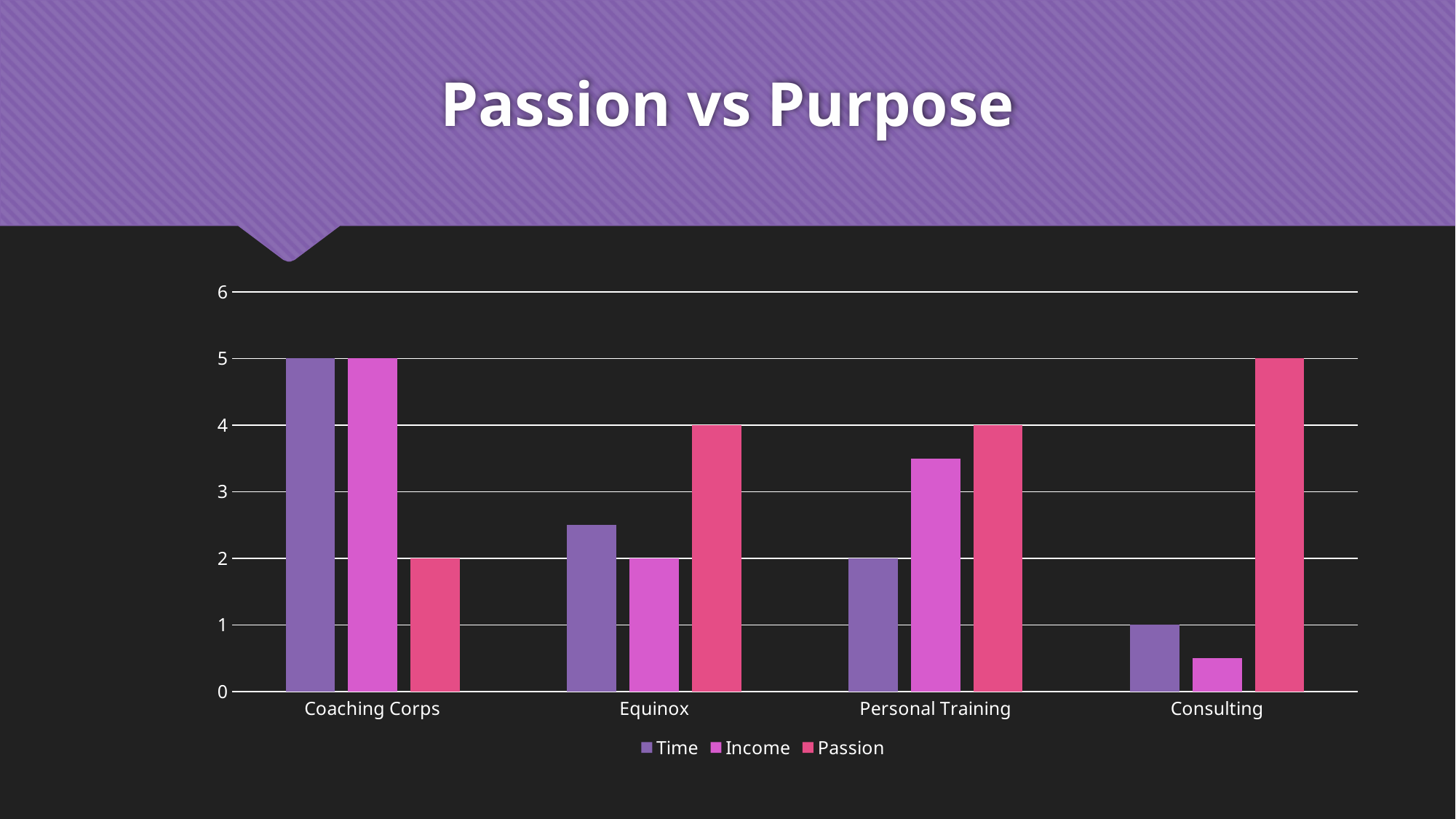
How many series does the legend list? 3 What kind of chart is shown on the slide? bar chart What is the Time value for Coaching Corps? 5 Which category has the highest Passion value? Consulting What is the title of the slide containing the chart? Passion vs Purpose Which category has the lowest Income value? Consulting Which is larger for Coaching Corps, the Time value or the Passion value? Time Is the Time value for Equinox greater or less than 2? greater What is the Passion value for Equinox? 4 Is the Income value for Personal Training greater or less than 4? less How many categories are shown on the x axis? 4 What is the Passion value for Consulting? 5